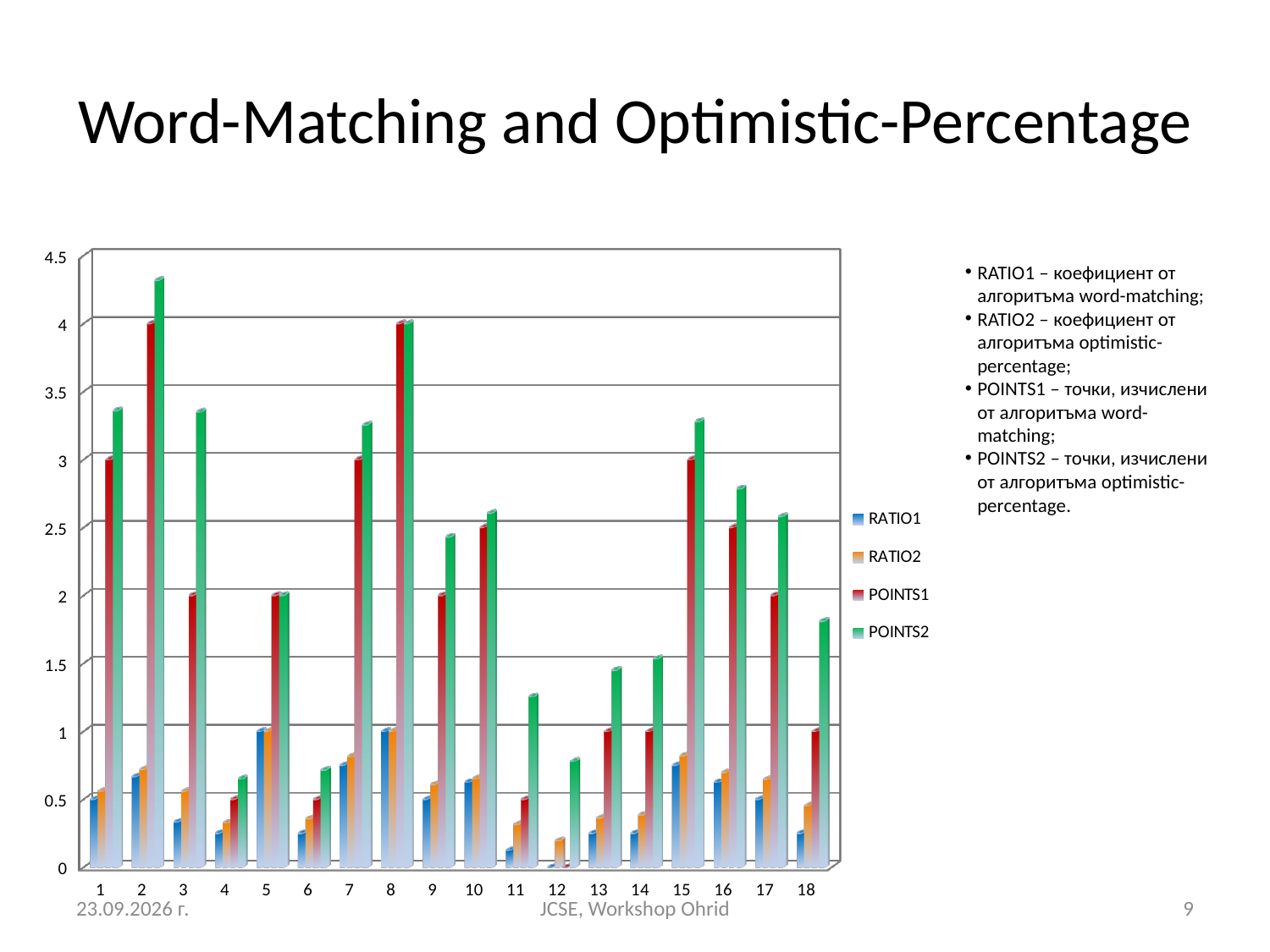
Is the RATIO1 value for category 15 greater or less than 0.5? greater What are the four series names listed in the chart legend? RATIO1, RATIO2, POINTS1, POINTS2 Is the POINTS2 value for category 18 greater or less than 1.5? greater Which category has the larger POINTS2 value: 16 or 17? 16 What kind of chart is shown on the slide? bar chart How many categories are shown along the x axis of the chart? 18 Which category has the highest POINTS2 value? 2 Which category has the lowest POINTS1 value? 12 For category 11, which is larger: POINTS1 or POINTS2? POINTS2 Is the POINTS2 value for category 2 greater or less than 4? greater How many series does the chart legend list? 4